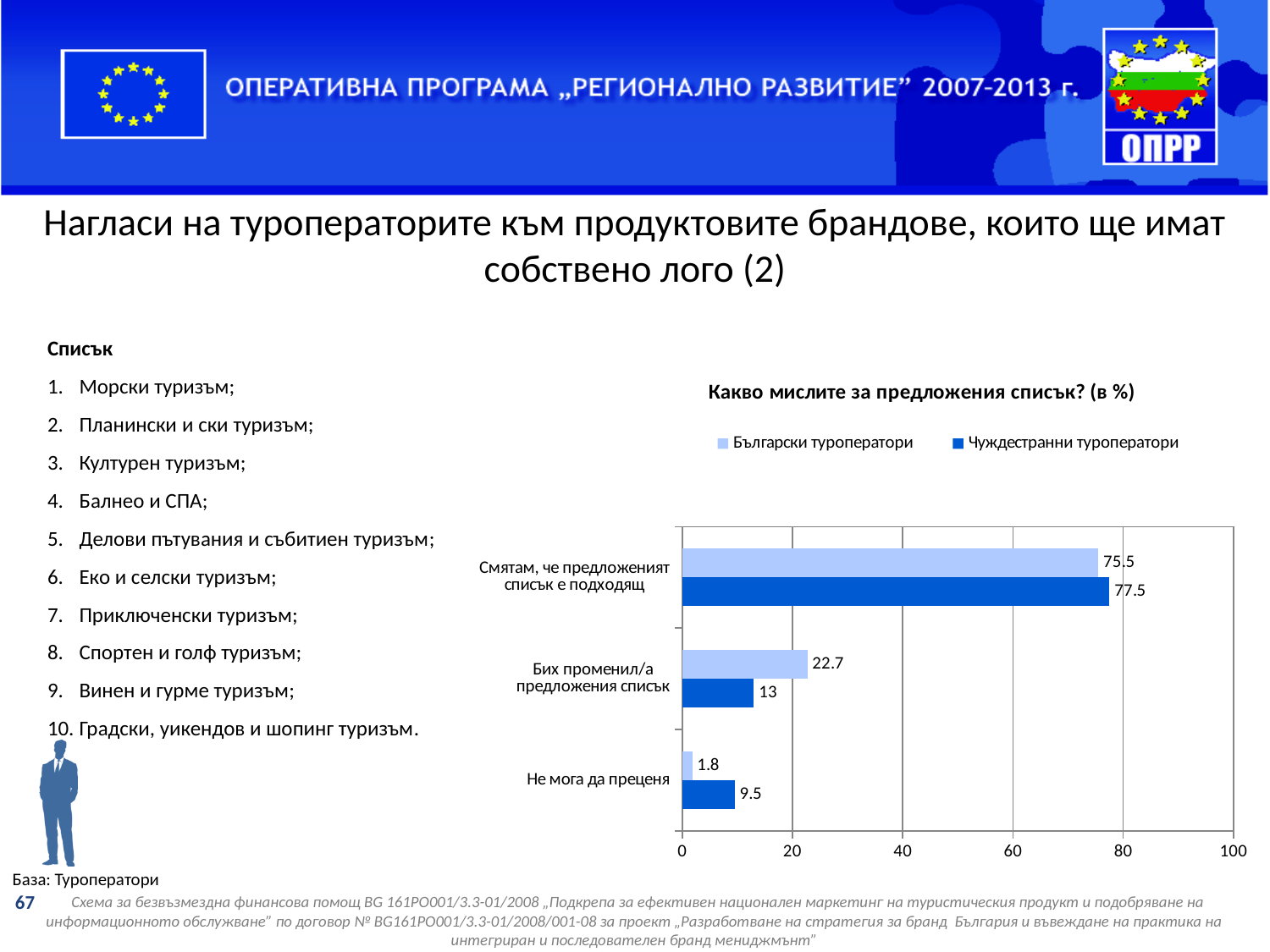
Is the value for Чуждестранни туроператори in "Смятам, че предложеният списък е подходящ" greater or less than 60? greater Which category has the highest value for Чуждестранни туроператори? Смятам, че предложеният списък е подходящ In the category "Не мога да преценя", which series has the larger value: Български туроператори or Чуждестранни туроператори? Чуждестранни туроператори What value is shown for Чуждестранни туроператори in the category "Не мога да преценя"? 9.5 Which category has the lowest value for Български туроператори? Не мога да преценя What type of chart is shown on the slide? bar chart What value is shown for Чуждестранни туроператори in the category "Бих променил/а предложения списък"? 13 What value is shown for Български туроператори in the category "Не мога да преценя"? 1.8 What is the difference between Български туроператори and Чуждестранни туроператори in the category "Бих променил/а предложения списък"? 9.7 What value is shown for Български туроператори in the category "Смятам, че предложеният списък е подходящ"? 75.5 How many categories are shown on the chart? 3 How many series does the chart legend list? 2